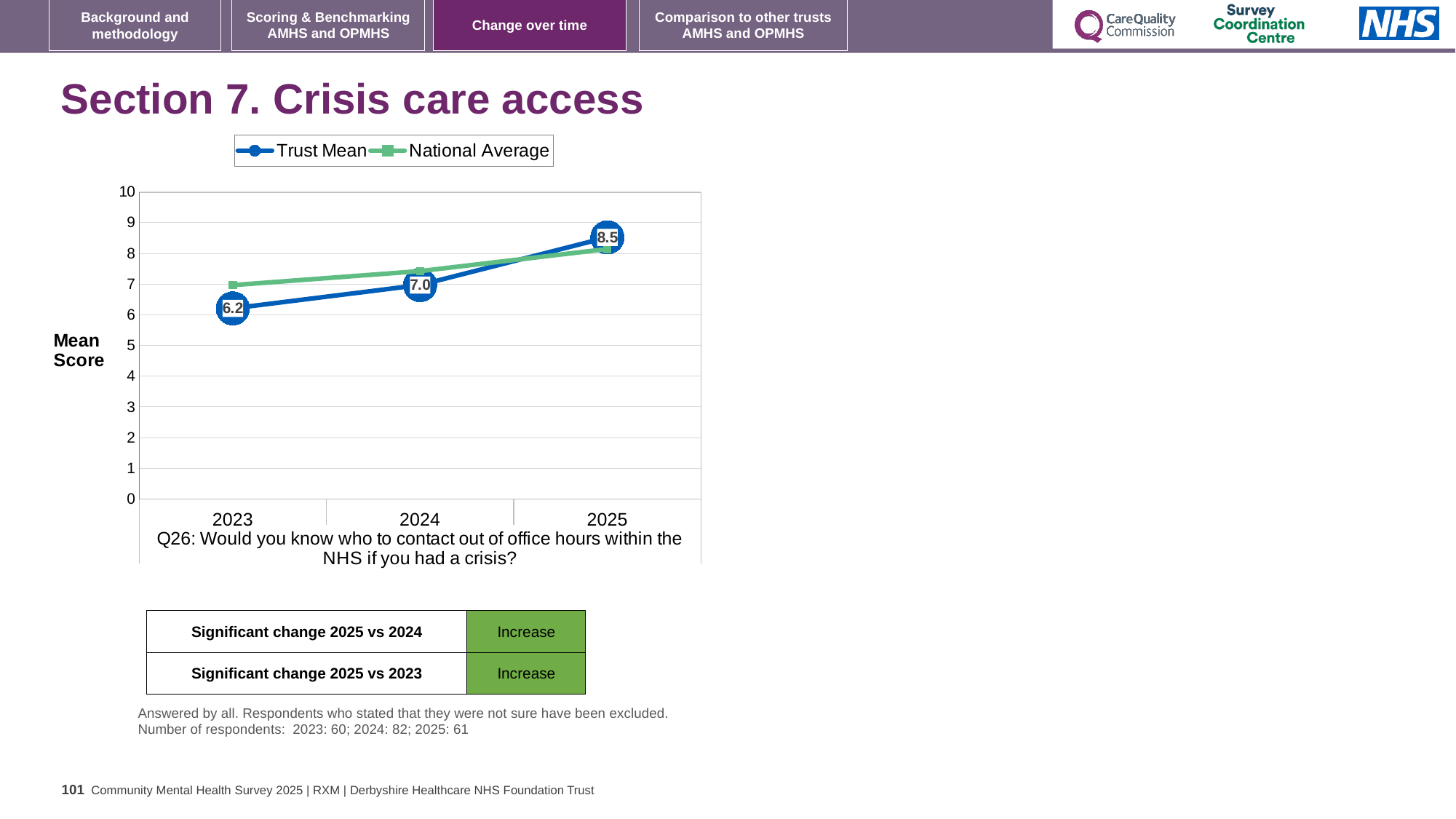
By how much did the Trust Mean increase from 2023 to 2025? 2.3 How many years are shown on the x axis of the chart? 3 What is the Trust Mean score for 2024? 7.0 In which year is the Trust Mean highest? 2025 What is the difference between the Trust Mean in 2025 and in 2024? 1.5 Is the National Average for 2023 greater or less than 8? less In which year is the Trust Mean lowest? 2023 How many series does the chart legend list? 2 What is the Trust Mean score for 2025? 8.5 What kind of chart is shown on the slide? Line chart In 2023, which is higher: the Trust Mean or the National Average? National Average What is the Trust Mean score for 2023? 6.2